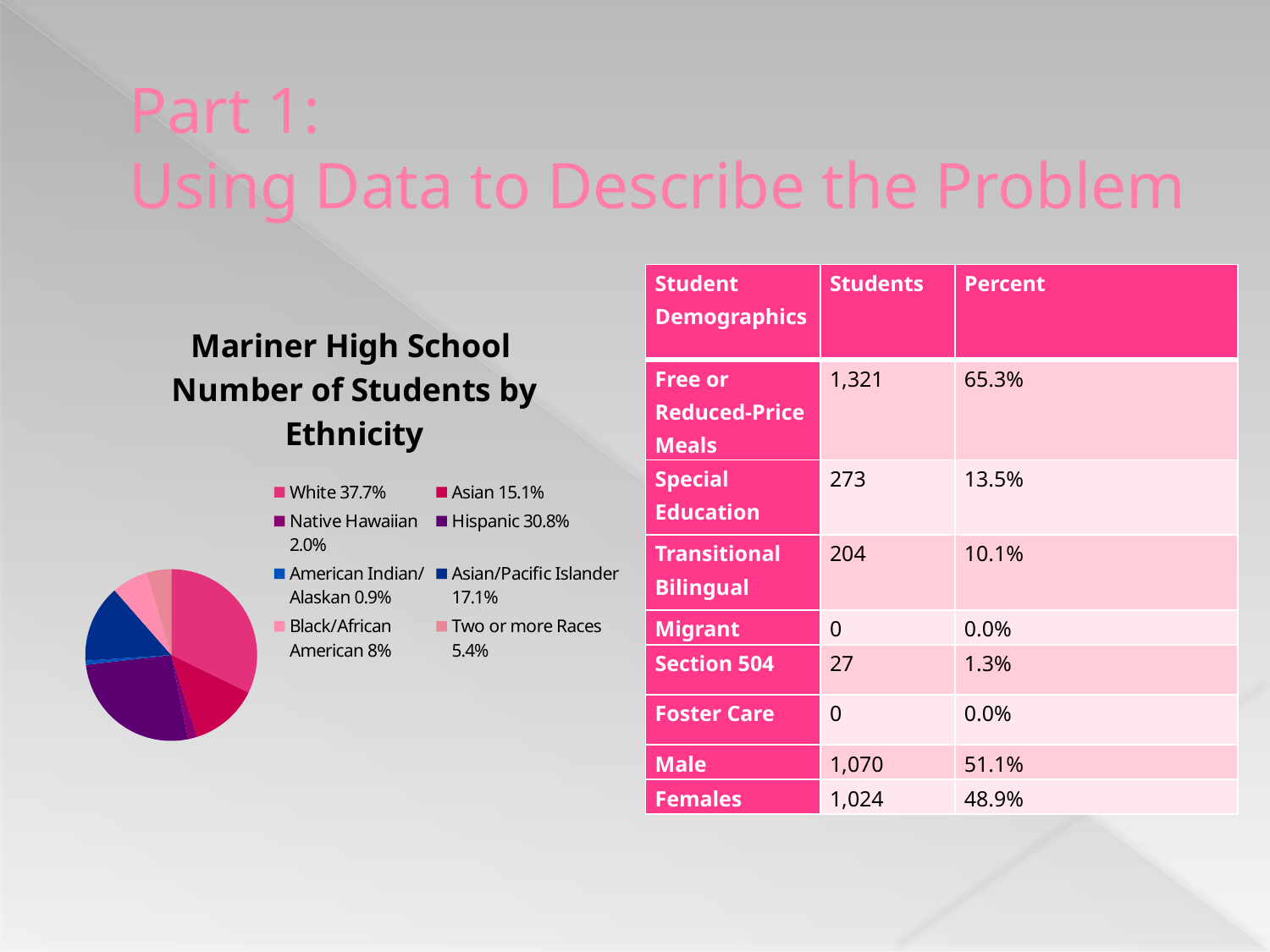
What is the title of the pie chart? Mariner High School Number of Students by Ethnicity What percentage of students does the pie chart show as White? 37.7% In the pie chart, which share is larger: Asian or Asian/Pacific Islander? Asian/Pacific Islander What percentage of students does the pie chart show as Hispanic? 30.8% Which ethnicity category has the smallest share in the pie chart? American Indian/Alaskan Which ethnicity category has the largest share in the pie chart? White How many ethnicity categories does the pie chart's legend list? 8 What percentage of students does the pie chart show as Asian/Pacific Islander? 17.1% What kind of chart is shown on the slide? pie chart In the pie chart, how many percentage points larger is the White share than the Hispanic share? 6.9